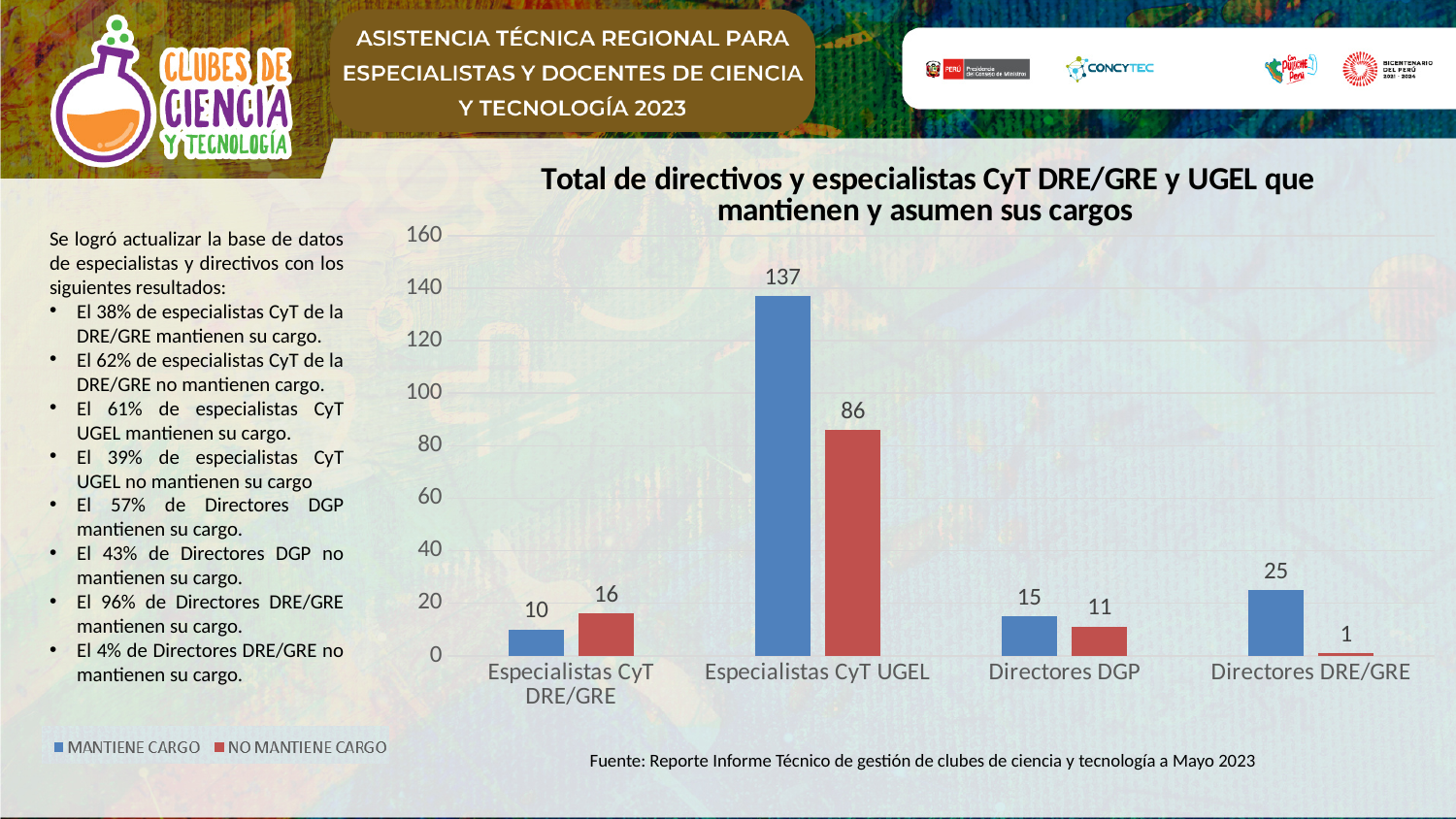
How many series does the legend list? 2 How many categories are shown on the x axis? 4 What is the value for NO MANTIENE CARGO for Directores DRE/GRE? 1 What is the difference between MANTIENE CARGO and NO MANTIENE CARGO for Especialistas CyT UGEL? 51 What is the total of MANTIENE CARGO and NO MANTIENE CARGO for Directores DGP? 26 What kind of chart is shown? Bar chart What is the value for NO MANTIENE CARGO for Directores DGP? 11 What is the value for MANTIENE CARGO for Especialistas CyT UGEL? 137 Which category has the highest MANTIENE CARGO value? Especialistas CyT UGEL Which is larger for Especialistas CyT DRE/GRE: MANTIENE CARGO or NO MANTIENE CARGO? NO MANTIENE CARGO Which category has the lowest NO MANTIENE CARGO value? Directores DRE/GRE What is the value for MANTIENE CARGO for Especialistas CyT DRE/GRE? 10